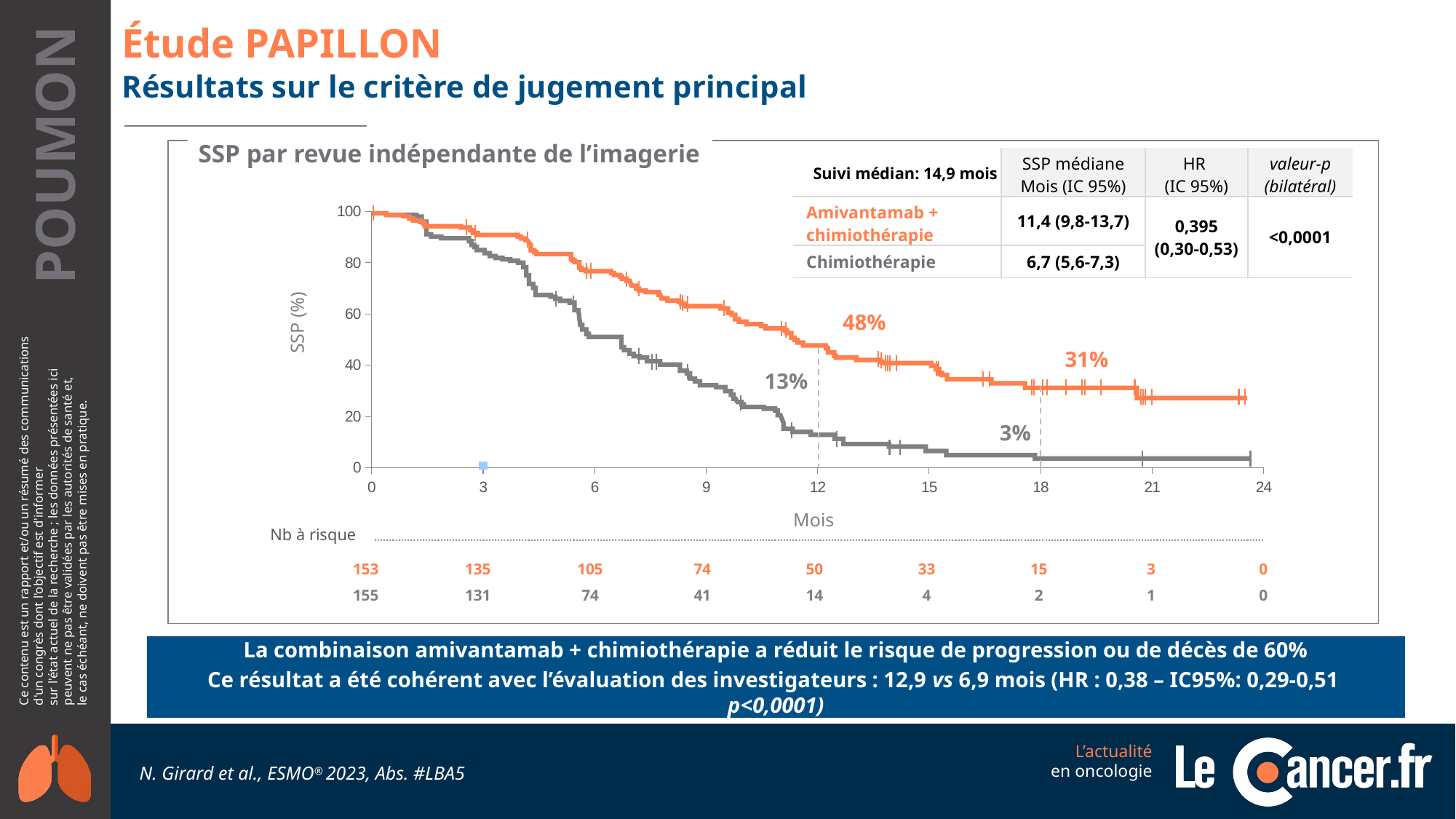
What is the difference in SSP rate between the two arms at 12 months? 35% Do the SSP curves rise or fall as months increase? Fall What is the hazard ratio (HR) shown in the table? 0,395 (0,30-0,53) What is the SSP rate for the Amivantamab + chimiothérapie arm at 12 months? 48% Which arm has the higher SSP rate at 18 months? Amivantamab + chimiothérapie What is the SSP rate for the Chimiothérapie arm at 18 months? 3% What kind of chart is shown on the slide? Line chart (Kaplan-Meier survival curve) How many patients were at risk in the Amivantamab + chimiothérapie arm at 12 months? 50 What is the SSP rate for the Amivantamab + chimiothérapie arm at 18 months? 31% What is the median SSP in months for the Amivantamab + chimiothérapie arm? 11,4 (9,8-13,7) What is the median SSP in months for the Chimiothérapie arm? 6,7 (5,6-7,3) How many patients were at risk in the Chimiothérapie arm at 6 months? 74